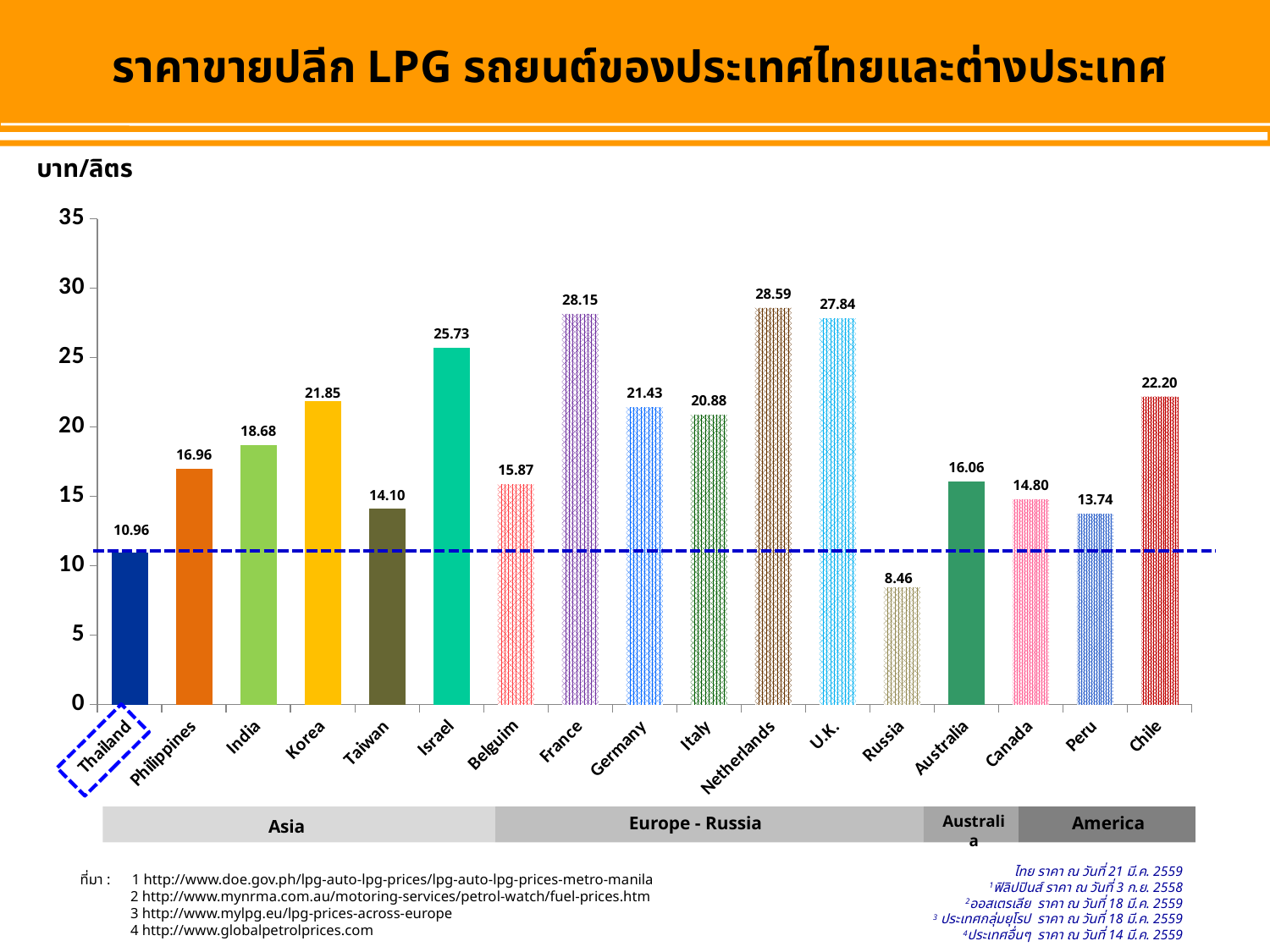
What is the value shown for Russia? 8.46 Which has a higher value, Korea or Germany? Korea What is the LPG retail price shown for Thailand? 10.96 What is the difference between the values for France and Belgium? 12.28 Which country has the highest value on the chart? Netherlands Which has a higher value, Canada or Peru? Canada What is the value shown for the Netherlands? 28.59 What unit is shown above the y axis of the chart? บาท/ลิตร Which country has the lowest value on the chart? Russia What kind of chart is shown on the slide? Bar chart How many countries are shown on the chart? 17 What is the difference between the values for Israel and Thailand? 14.77